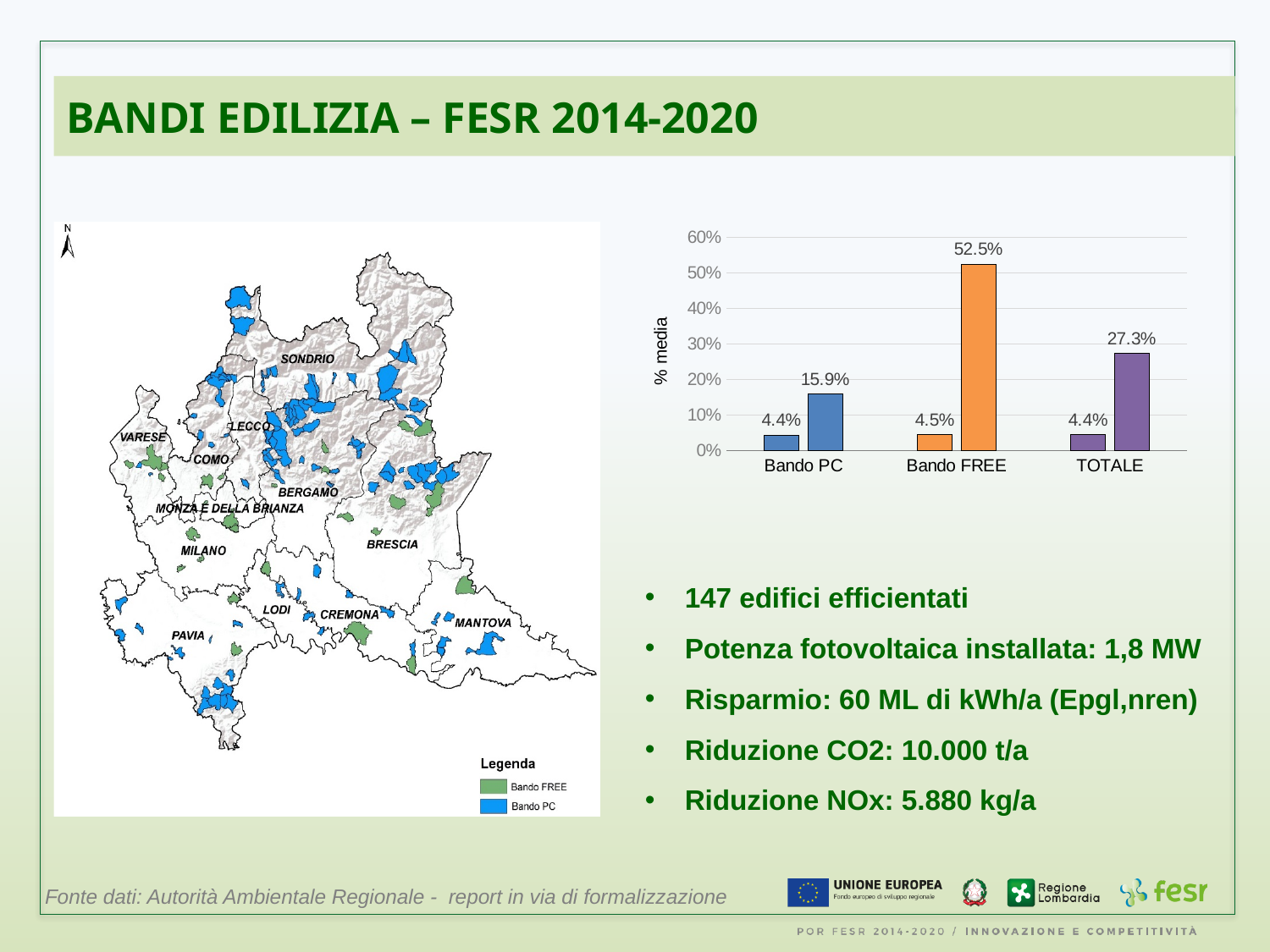
In the bar chart, what is the value of the taller (right-hand) bar for TOTALE? 27.3% In the bar chart, what is the difference between the taller bars of Bando FREE and TOTALE? 25.2% What is the label of the vertical axis of the bar chart? % media In the bar chart, what is the value of the taller (right-hand) bar for Bando PC? 15.9% What type of chart is shown on the right side of the slide? bar chart In the bar chart, what is the value of the shorter (left-hand) bar for Bando FREE? 4.5% In the bar chart, is the taller bar for Bando PC larger or smaller than the taller bar for TOTALE? smaller In the bar chart, what is the value of the shorter (left-hand) bar for TOTALE? 4.4% In the bar chart, what is the difference between the two bars for Bando FREE? 48.0% Which category has the highest bar in the bar chart? Bando FREE How many categories are shown on the x axis of the bar chart? 3 In the bar chart, what is the value of the taller (right-hand) bar for Bando FREE? 52.5%